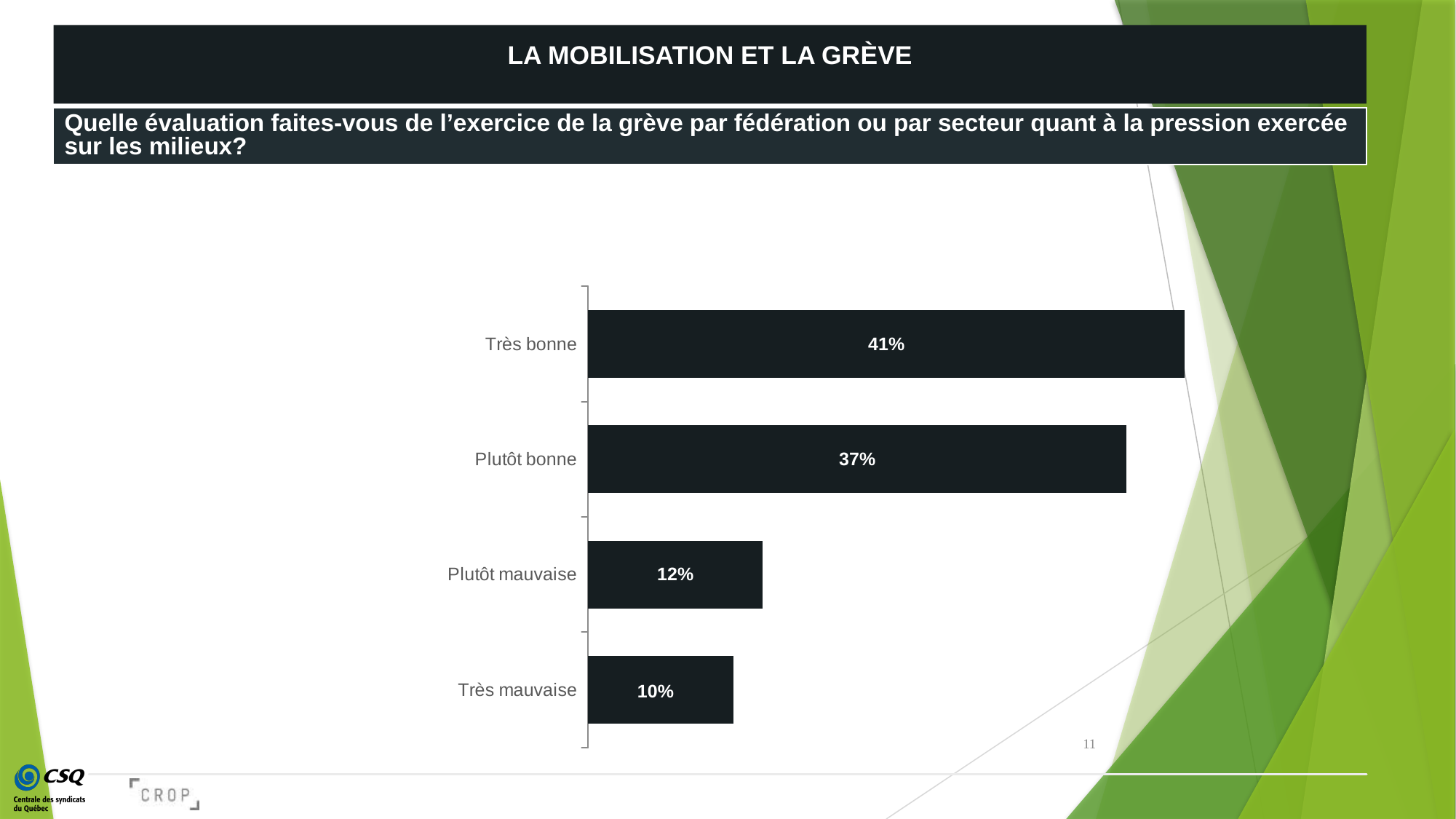
What is the value for Plutôt mauvaise? 12% Which category has the highest value? Très bonne What kind of chart is shown on the slide? Bar chart Which is larger, the value for Plutôt bonne or the value for Plutôt mauvaise? Plutôt bonne What is the difference between the values for Plutôt mauvaise and Très mauvaise? 2% What is the combined value of Très bonne and Plutôt bonne? 78% What is the difference between the values for Très bonne and Plutôt bonne? 4% What is the value for Plutôt bonne? 37% Which category has the lowest value? Très mauvaise What is the value for Très bonne? 41% How many categories are shown in the chart? 4 What is the value for Très mauvaise? 10%